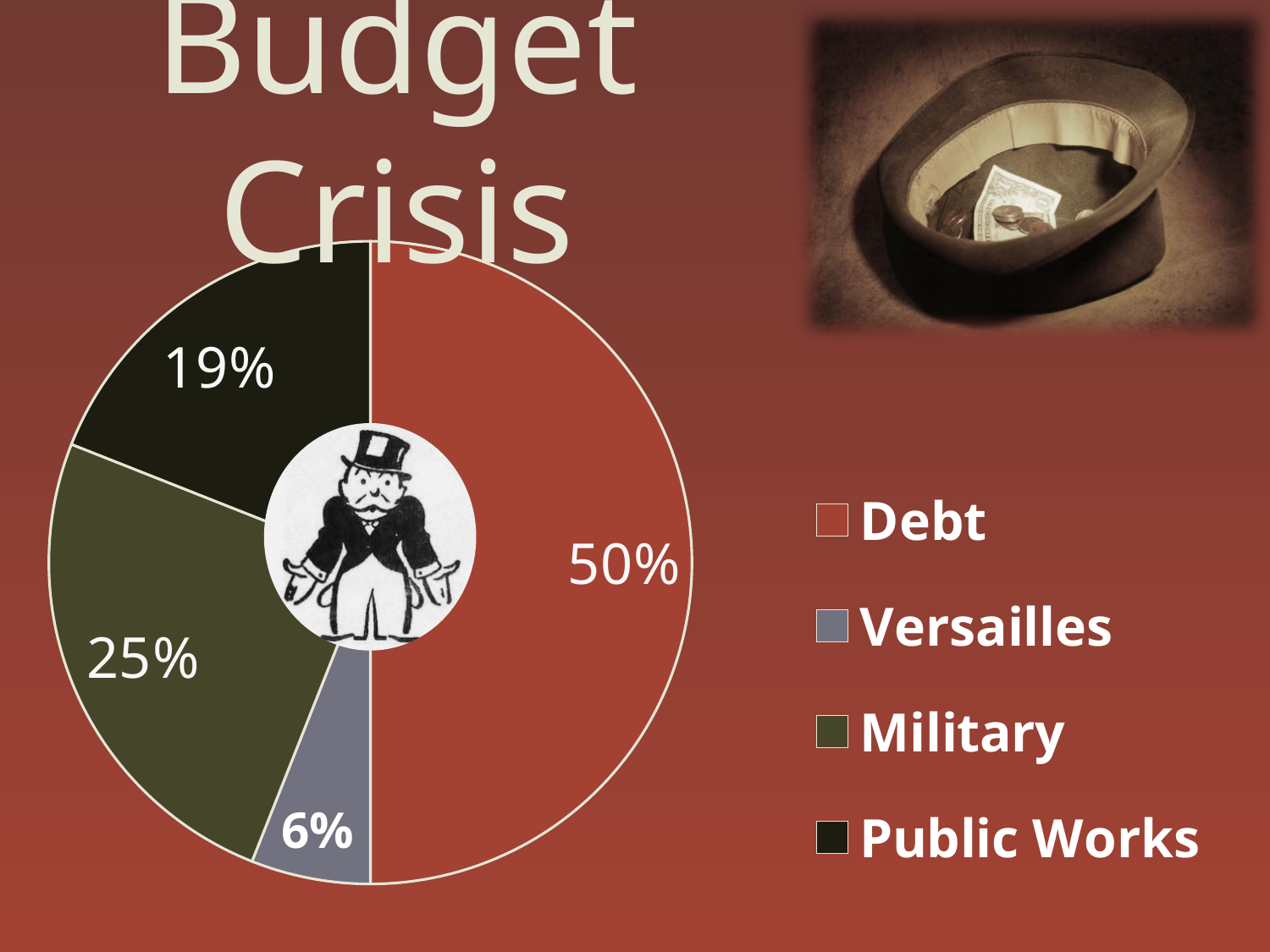
Which category has the smallest slice of the pie? Versailles Which slice is larger, Military or Public Works? Military What share of the pie does Debt take? 50% What share of the pie does Military take? 25% Which category has the largest slice of the pie? Debt What is the title shown above the chart? Budget Crisis What share of the pie does Public Works take? 19% What share of the pie does Versailles take? 6% What is the difference in percentage points between the Debt slice and the Military slice? 25 Which legend entry is shown in the darkest colour? Public Works How many slices does the pie chart have? 4 What kind of chart is shown on the slide? Pie chart